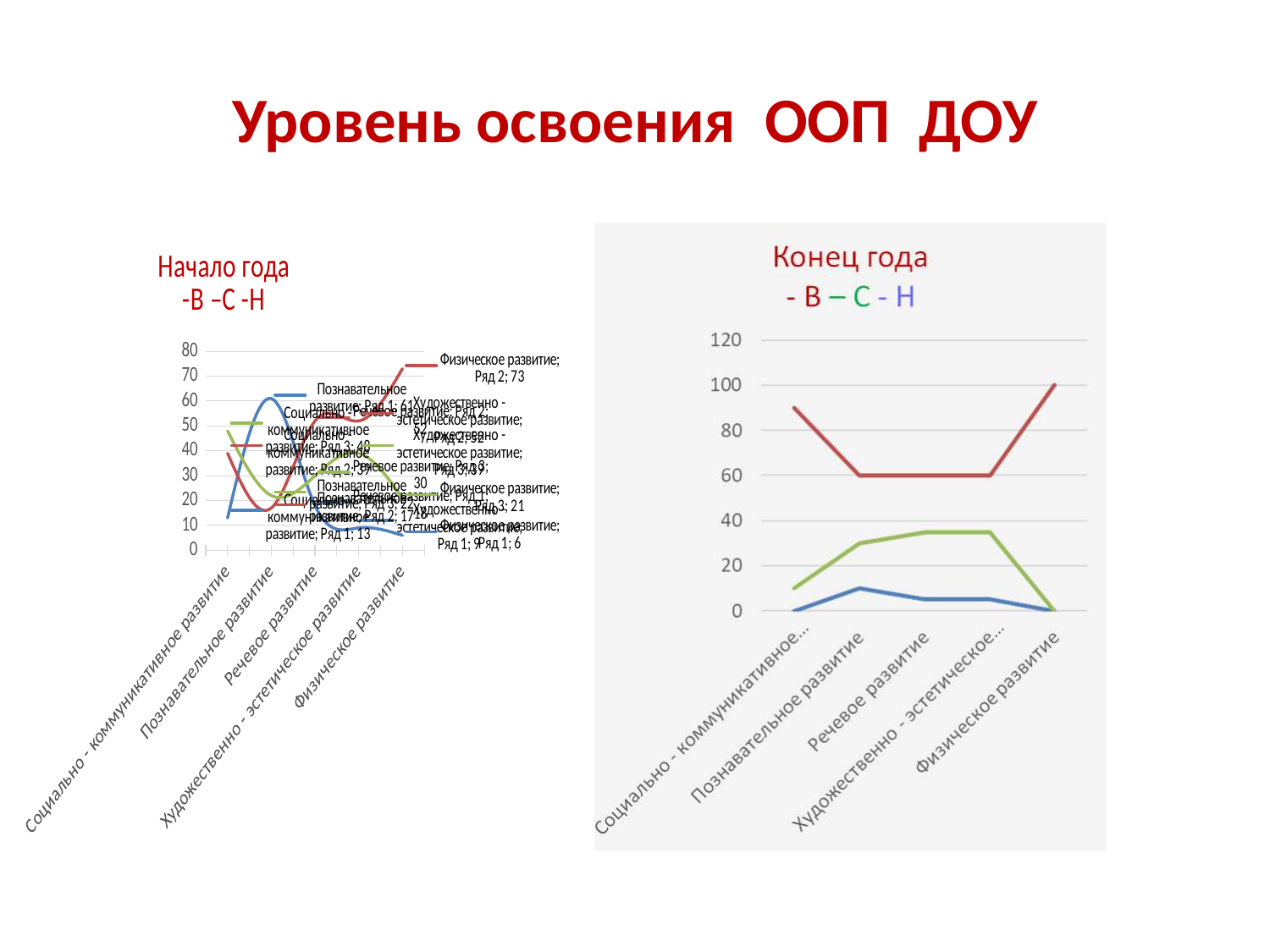
What is the title of the chart on the right side of the slide? Конец года In the 'Конец года' chart, what is the value of the red В series for Физическое развитие? 100 In the 'Начало года' chart, what is the value of Ряд 1 for Познавательное развитие? 61 In the 'Начало года' chart, what is the value of Ряд 2 for Физическое развитие? 73 What kind of chart is the 'Конец года' chart on the right? line chart In the 'Конец года' chart, is the value of the green С series for Речевое развитие greater or less than 20? greater How many categories are shown on the x axis of the 'Конец года' chart? 5 In the 'Конец года' chart, is the value of the red В series for Социально-коммуникативное развитие greater or less than 80? greater How many series does the legend of the 'Конец года' chart list? 3 In the 'Конец года' chart, which category has the highest value for the red В series? Физическое развитие In the 'Конец года' chart, what is the value of the red В series for Познавательное развитие? 60 In the 'Конец года' chart, for Физическое развитие, which series is larger: В or С? В